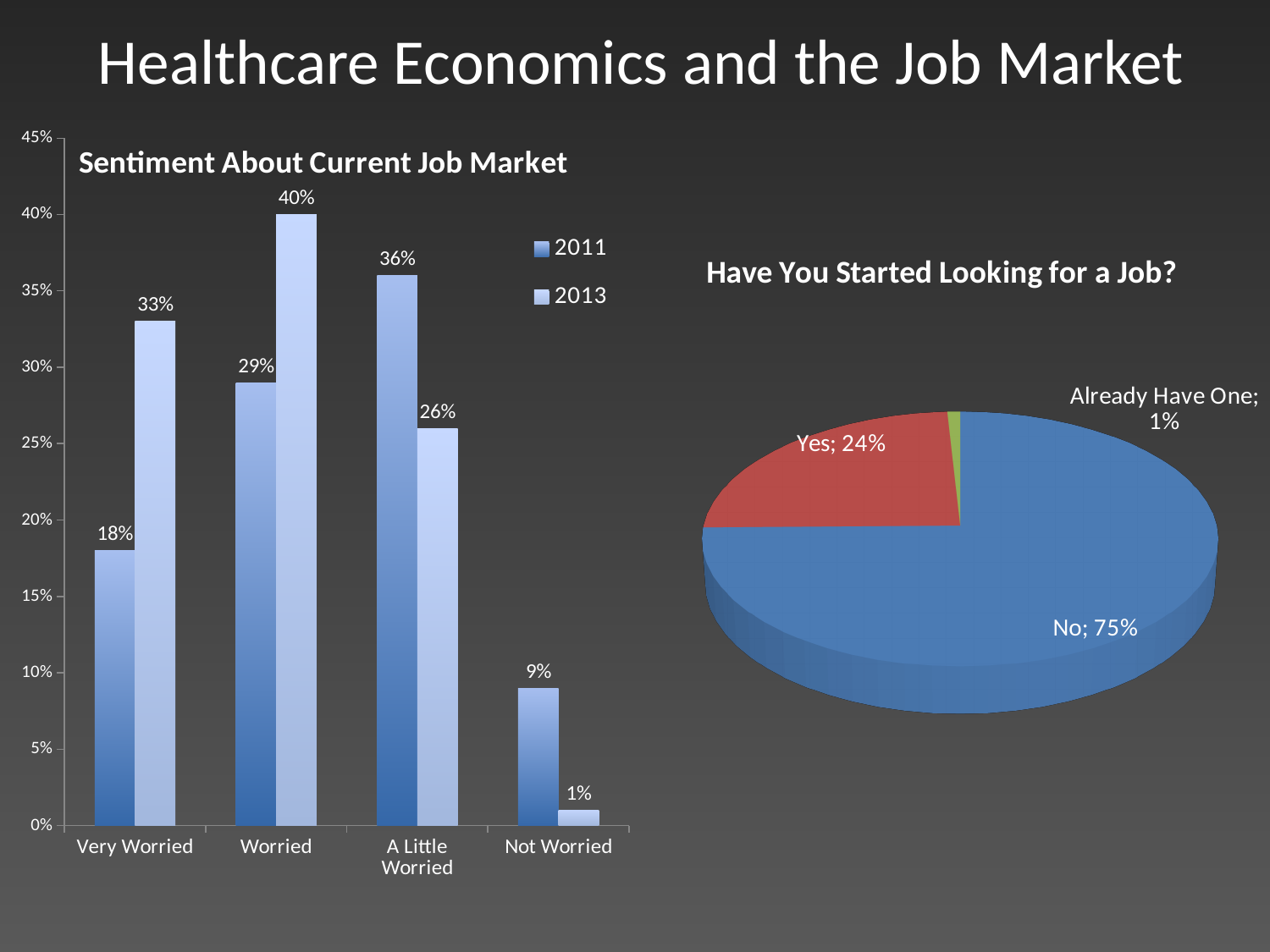
In the 'Have You Started Looking for a Job?' chart, what share of the pie is 'Yes'? 24% In the 'Sentiment About Current Job Market' chart, which category has the highest 2011 value? A Little Worried How many series does the legend of the 'Sentiment About Current Job Market' chart list? 2 In the 'Sentiment About Current Job Market' chart, what is the 2013 value for Worried? 40% What kind of chart is 'Sentiment About Current Job Market'? Bar chart In the 'Have You Started Looking for a Job?' chart, which slice is the largest? No In the 'Sentiment About Current Job Market' chart, which category has the lowest 2013 value? Not Worried What kind of chart is 'Have You Started Looking for a Job?'? Pie chart How many categories are shown on the x axis of the 'Sentiment About Current Job Market' chart? 4 In the 'Sentiment About Current Job Market' chart, what is the 2011 value for Very Worried? 18% In the 'Sentiment About Current Job Market' chart, which is larger for A Little Worried: the 2011 value or the 2013 value? 2011 In the 'Sentiment About Current Job Market' chart, what is the difference between the 2013 and 2011 values for Very Worried? 15%